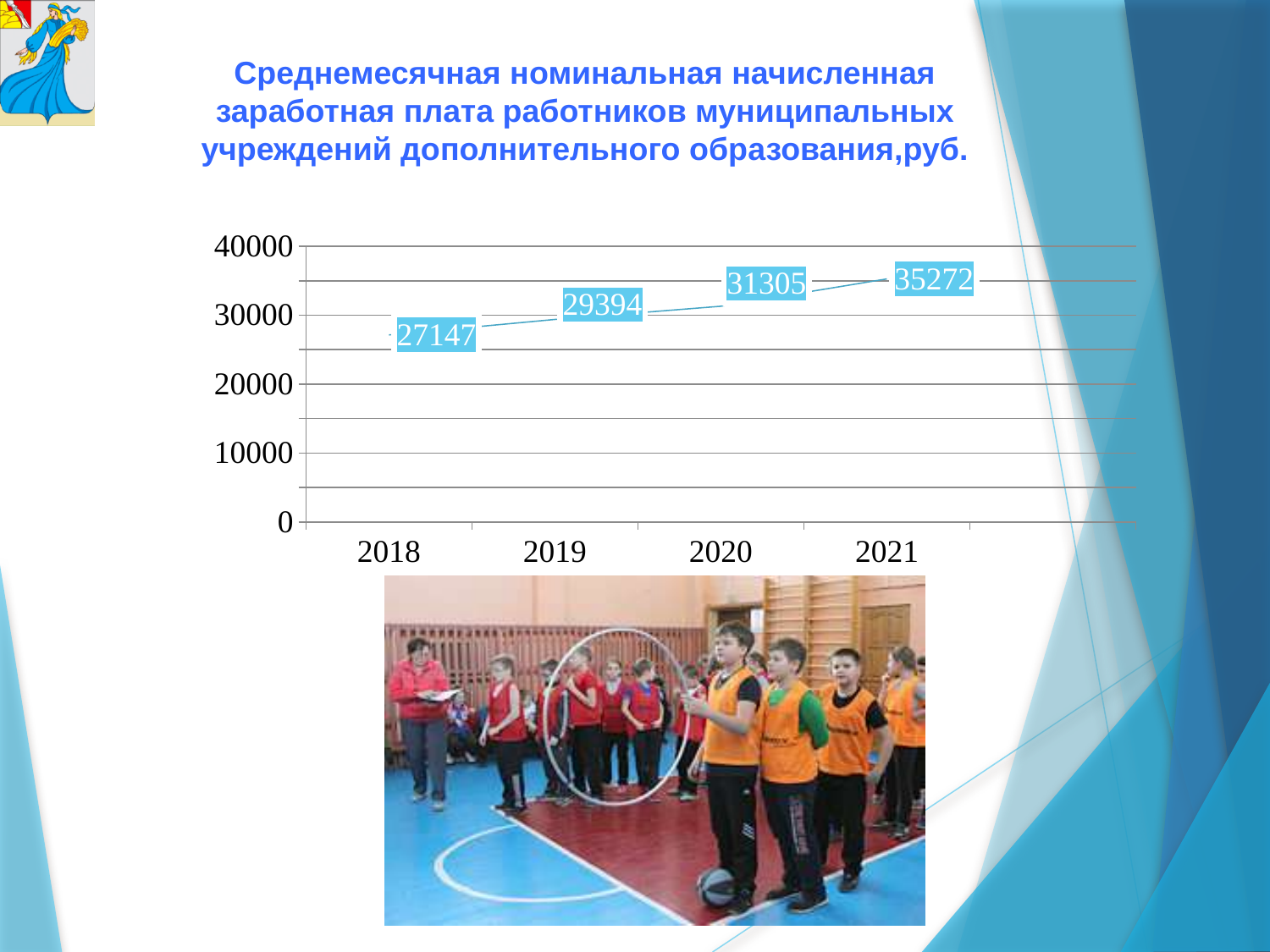
What was the average monthly salary in 2019? 29394 What was the average monthly salary in 2018? 27147 By how much did the average monthly salary increase from 2018 to 2021? 8125 Which year has the lowest average monthly salary? 2018 Which year has a larger value, 2019 or 2020? 2020 How many years are shown on the x axis? 4 What was the average monthly salary in 2020? 31305 What was the average monthly salary in 2021? 35272 What is the difference between the 2020 and 2019 values? 1911 Is the value for 2018 greater or less than 30000? less What kind of chart is shown on the slide? line chart Which year has the highest average monthly salary? 2021